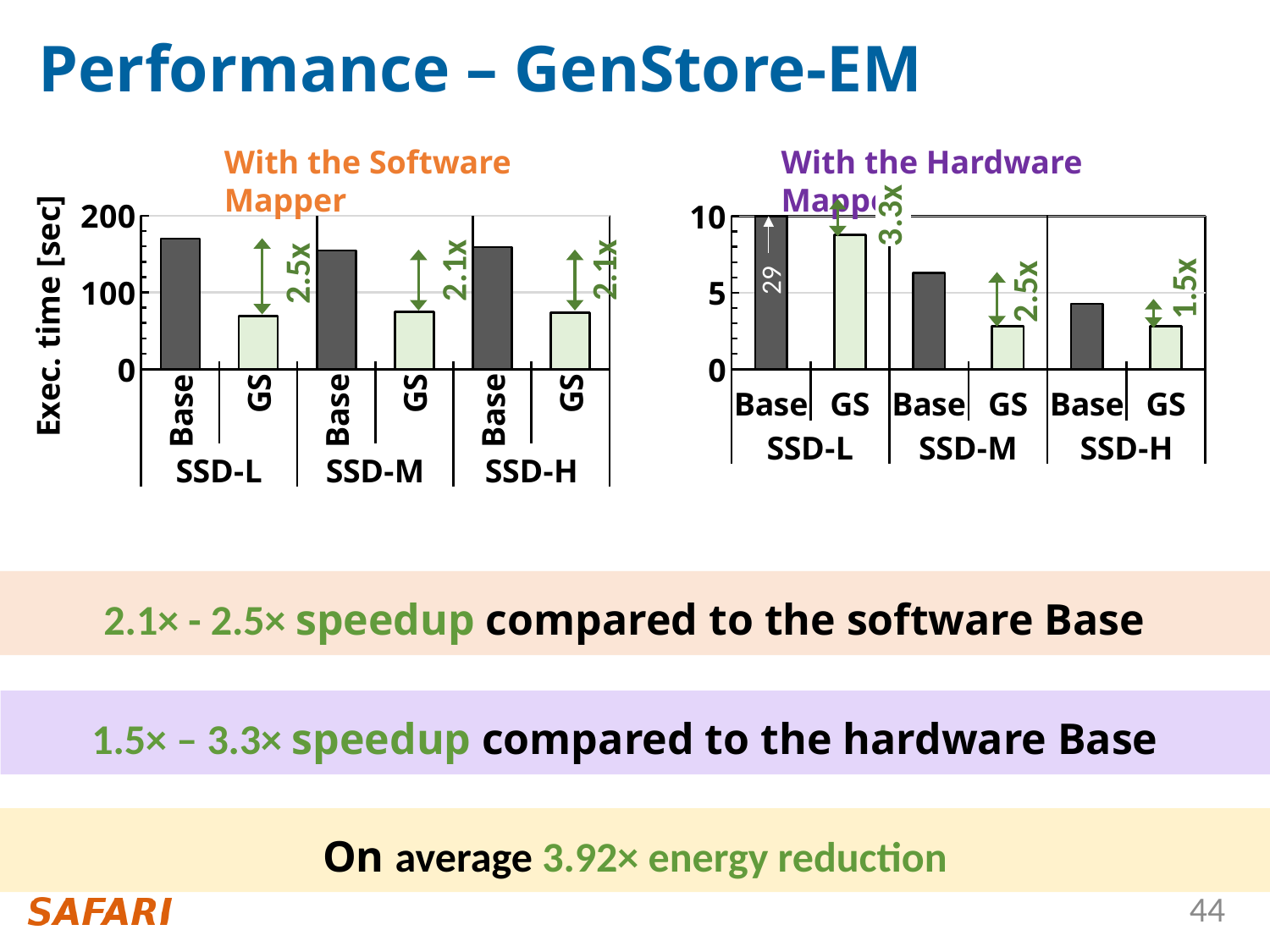
In the "With the Software Mapper" chart, is the GS value for SSD-L greater or less than 100? less How many SSD configurations are shown in the "With the Software Mapper" chart? 3 In the "With the Software Mapper" chart, which is larger for SSD-M, Base or GS? Base In the "With the Hardware Mapper" chart, which SSD configuration has the highest annotated speedup? SSD-L In the "With the Software Mapper" chart, what speedup is annotated for SSD-L? 2.5x In the "With the Software Mapper" chart, is the Base value for SSD-L greater or less than 100? greater What kind of chart is shown under "With the Software Mapper"? bar chart In the "With the Hardware Mapper" chart, what speedup is annotated for SSD-H? 1.5x In the "With the Hardware Mapper" chart, what value is printed on the Base bar for SSD-L? 29 In the "With the Hardware Mapper" chart, is the GS value for SSD-M greater or less than 5? less In the "With the Hardware Mapper" chart, what speedup is annotated for SSD-L? 3.3x In the "With the Software Mapper" chart, what speedup is annotated for SSD-M? 2.1x